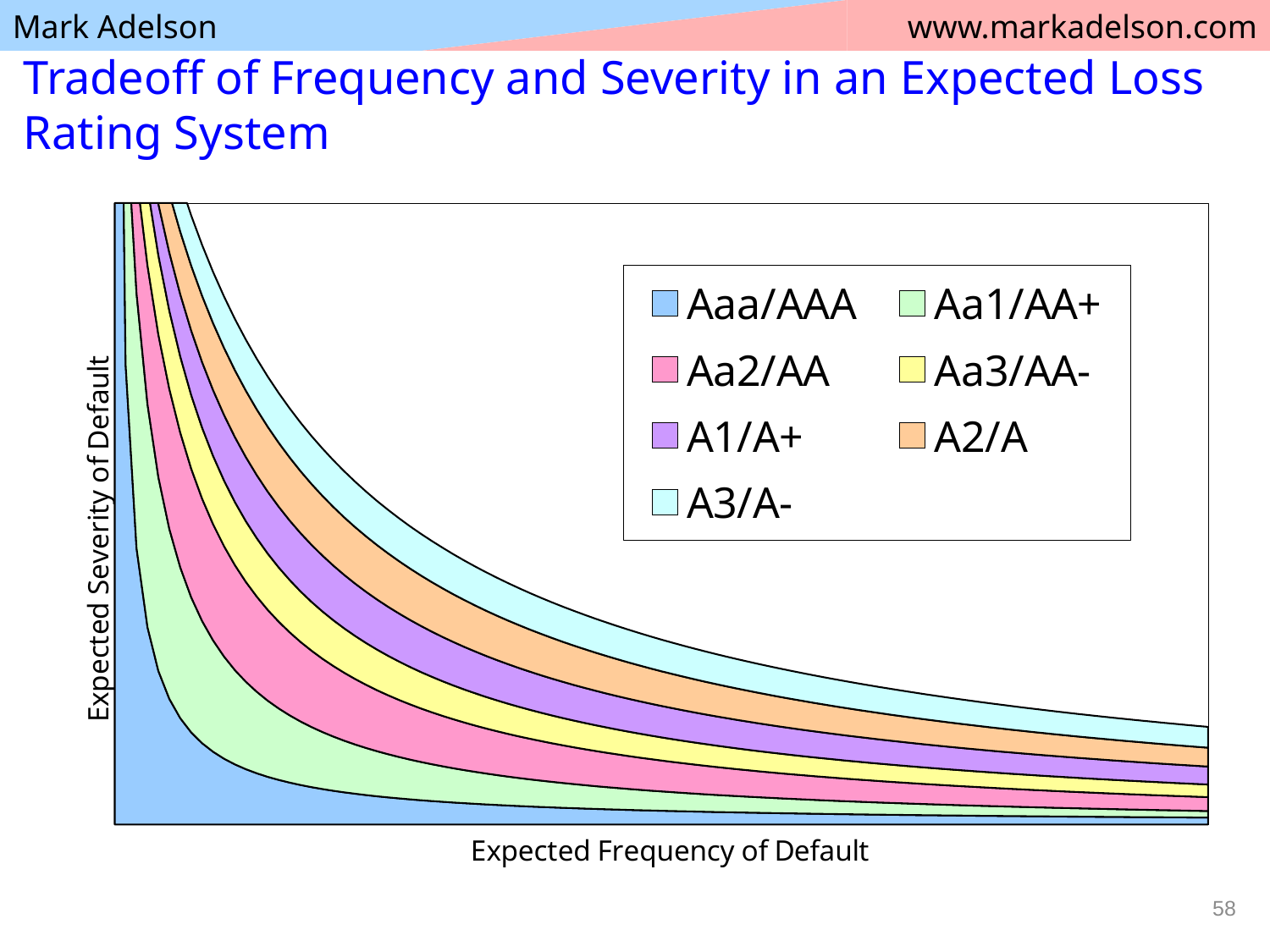
Do the boundary curves between the rating bands rise or fall as Expected Frequency of Default increases along the x axis? Fall How many series does the chart's legend list? 7 Which legend entry is shown in blue? Aaa/AAA What kind of chart is shown on the slide? Stacked area chart What is the title of the chart's x axis? Expected Frequency of Default